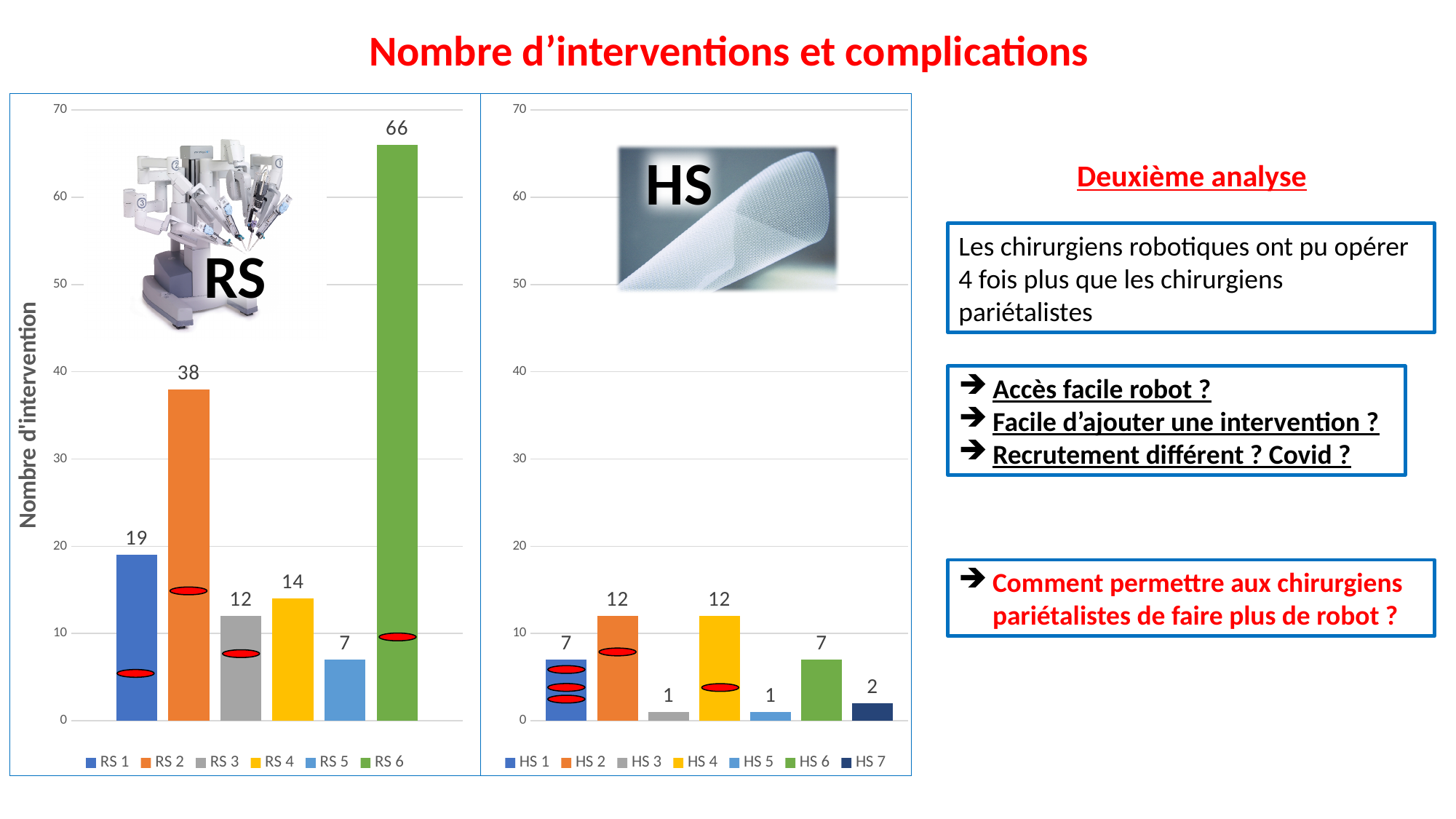
What is the label of the vertical axis on the left (RS) chart? Nombre d'intervention In the right (HS) chart, is the value for HS 2 greater or less than 10? greater In the left (RS) chart, what is the difference between the values for RS 6 and RS 2? 28 In the right (HS) chart, what is the difference between the values for HS 4 and HS 6? 5 In the right (HS) chart, what is the value for HS 7? 2 In the left (RS) chart, which category has the lowest value? RS 5 In the left (RS) chart, what is the value for RS 2? 38 In the right (HS) chart, how many bars are plotted? 7 What type of chart is the left (RS) chart? bar chart In the left (RS) chart, how many categories are shown in the legend? 6 In the right (HS) chart, which is larger, the value for HS 1 or the value for HS 2? HS 2 In the left (RS) chart, which category has the highest value? RS 6